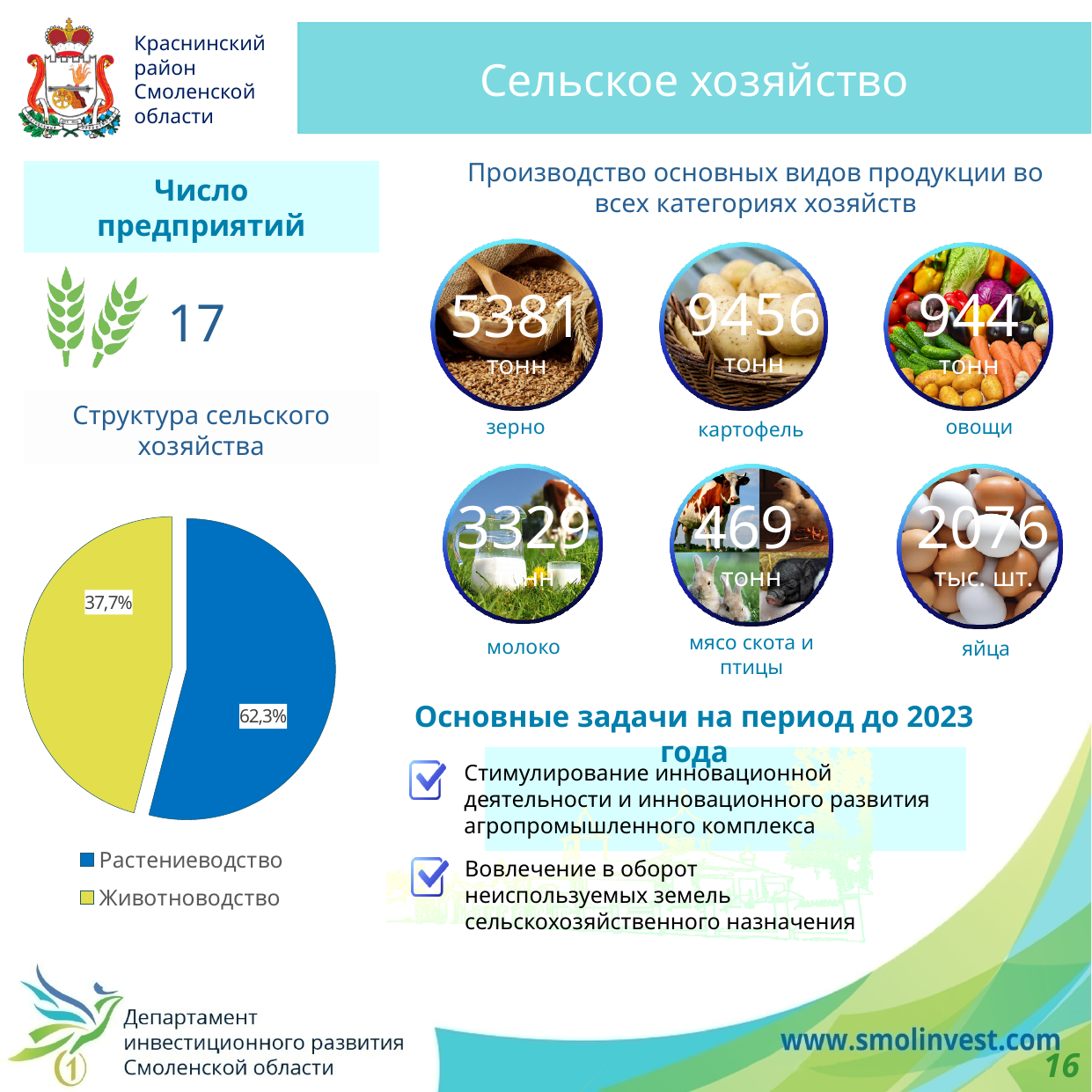
Which category has the smallest slice in the pie chart? Животноводство What colour is the Животноводство slice in the pie chart? yellow Is the share for Животноводство greater or less than 50%? less What is the difference in percentage points between the Растениеводство and Животноводство slices? 24,6 What share of the pie chart does Растениеводство have? 62,3% How many categories does the pie chart show? 2 How many entries does the pie chart legend list? 2 What share of the pie chart does Животноводство have? 37,7% Which category has the largest slice in the pie chart? Растениеводство What kind of chart is shown under "Структура сельского хозяйства"? pie chart Which is larger in the pie chart, Растениеводство or Животноводство? Растениеводство What is the title above the pie chart? Структура сельского хозяйства